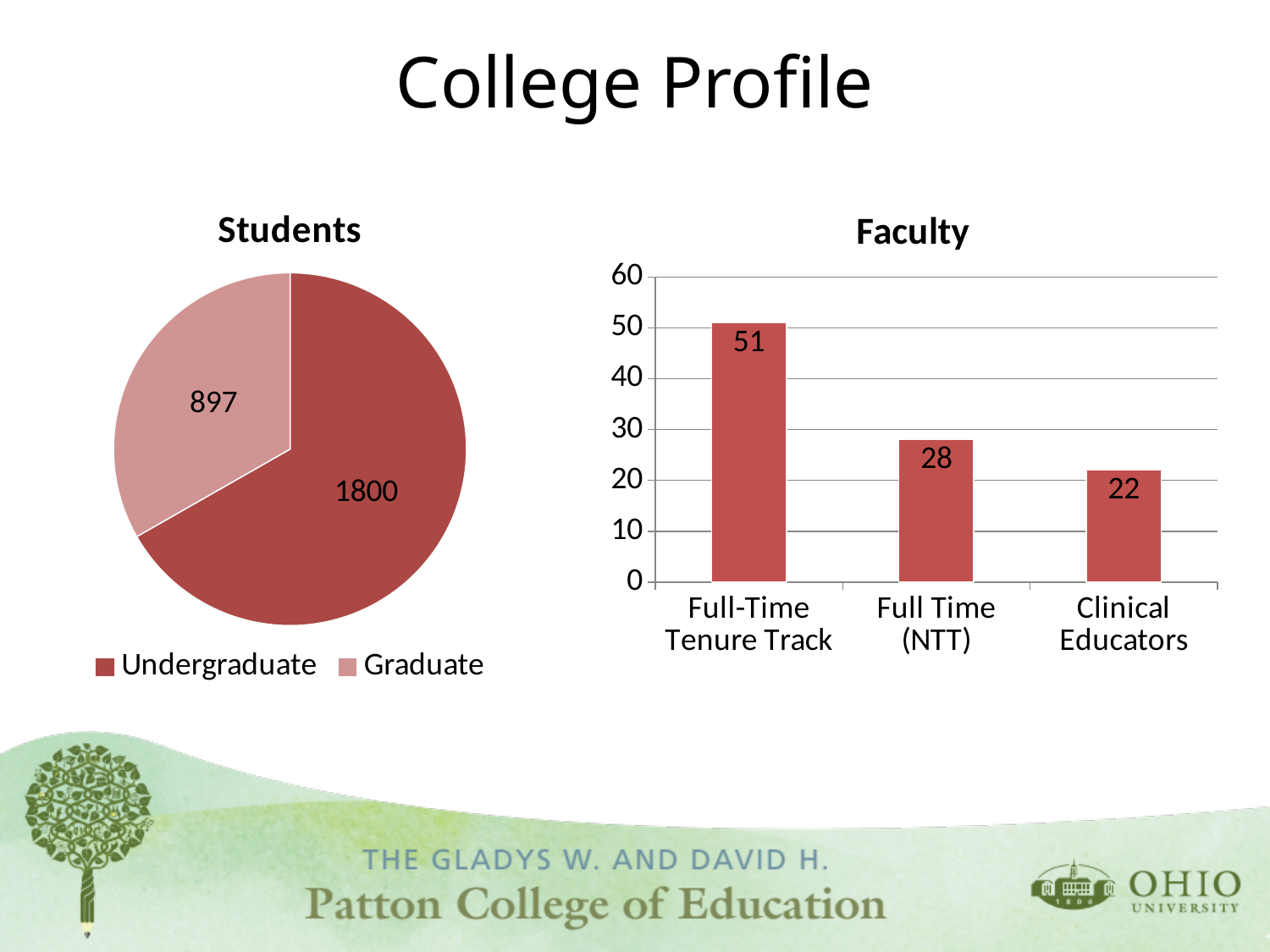
In the Faculty chart, what is the value for Clinical Educators? 22 In the Students pie chart, what share of the total does Undergraduate represent? 66.7% In the Students pie chart, what is the value for Undergraduate? 1800 In the Faculty chart, which category has the lowest value? Clinical Educators How many categories are shown in the Faculty chart? 3 What kind of chart is the Students chart? Pie chart In the Students pie chart, what is the value for Graduate? 897 In the Faculty chart, which is larger: Full Time (NTT) or Clinical Educators? Full Time (NTT) In the Faculty chart, which category has the highest value? Full-Time Tenure Track In the Faculty chart, what is the value for Full-Time Tenure Track? 51 In the Students pie chart, what is the difference between Undergraduate and Graduate? 903 In the Faculty chart, what is the difference between Full-Time Tenure Track and Full Time (NTT)? 23